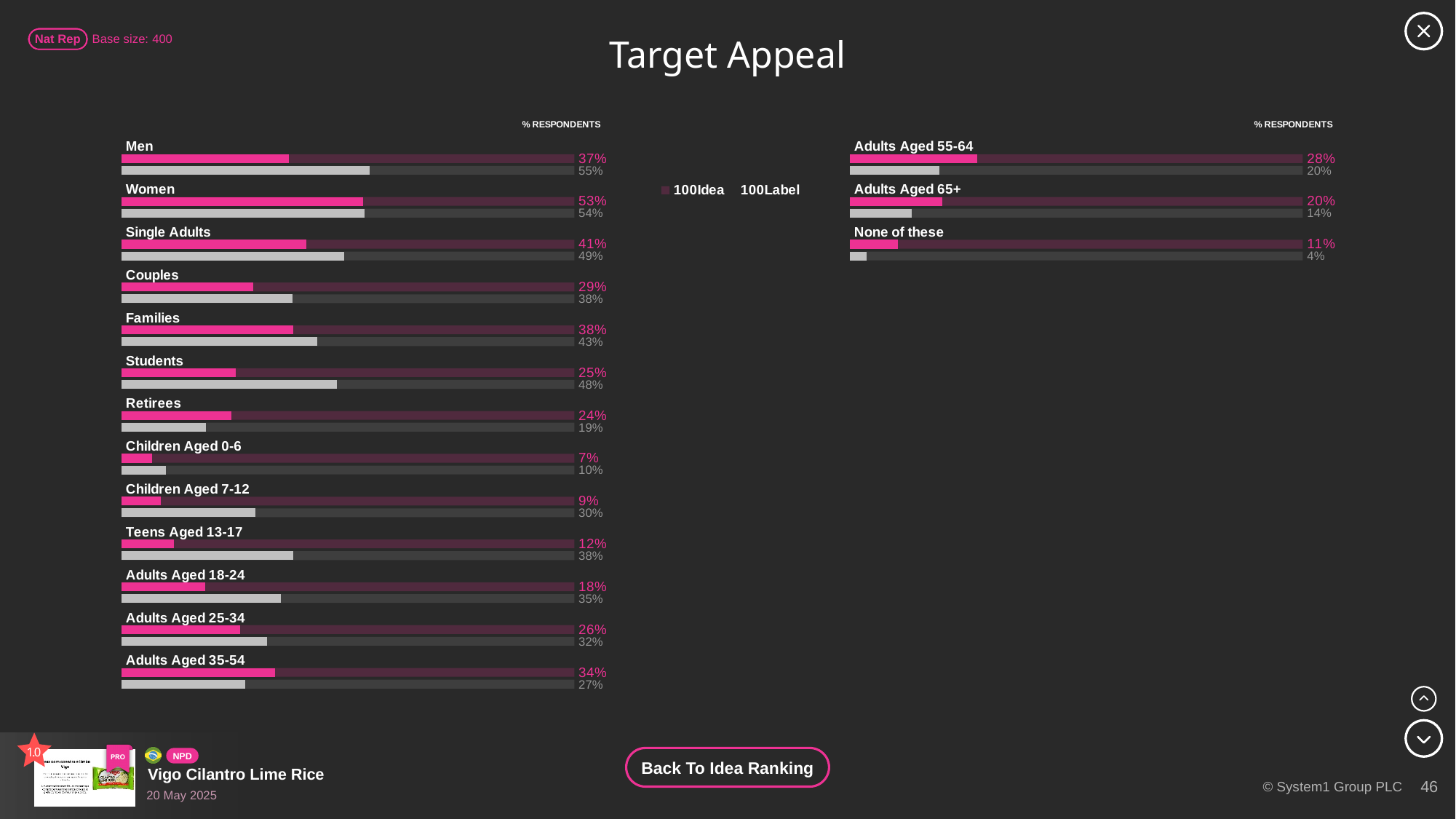
What kind of chart is shown on the slide? bar chart What is the pink (Idea) value for Men? 37% How many series does the legend list? 2 Which category has the lowest grey (Label) value? None of these Which category has the highest pink (Idea) value? Women Which category has the lowest pink (Idea) value? Children Aged 0-6 What is the difference between the grey (Label) value and the pink (Idea) value for Teens Aged 13-17? 26% Which is larger for Retirees, the pink (Idea) value or the grey (Label) value? the pink (Idea) value What is the grey (Label) value for Students? 48% What is the pink (Idea) value for Adults Aged 65+? 20% How many target categories are shown on the slide? 16 Which is larger for Children Aged 7-12, the pink (Idea) value or the grey (Label) value? the grey (Label) value